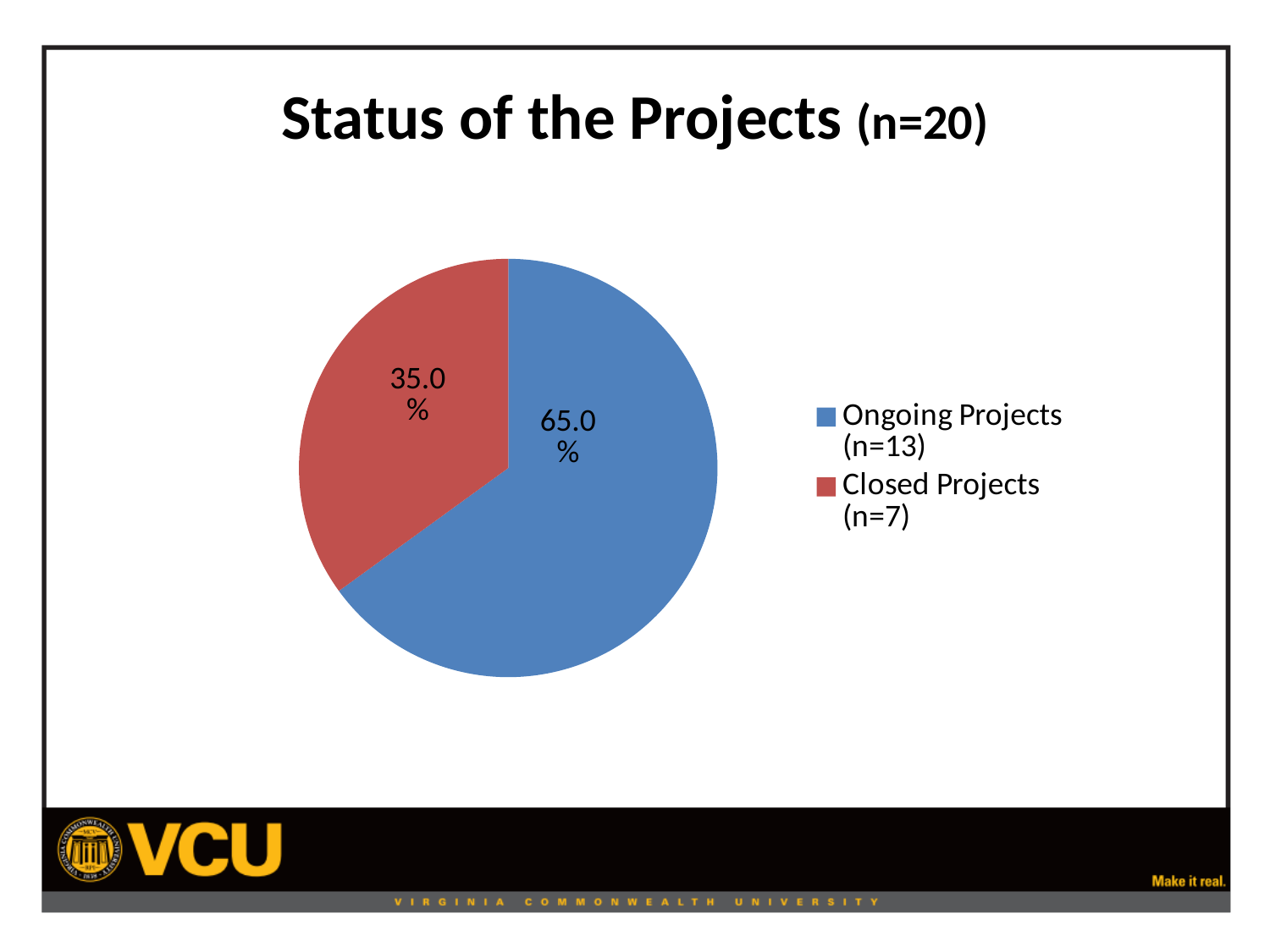
How many projects are ongoing according to the legend? 13 Which slice of the pie is the largest? Ongoing Projects (n=13) What is the title of the chart? Status of the Projects (n=20) Which slice of the pie is the smallest? Closed Projects (n=7) How many entries does the legend list? 2 What colour is the Closed Projects slice? red How many slices does the pie chart have? 2 What is the difference in percentage points between the Ongoing Projects slice and the Closed Projects slice? 30.0% What kind of chart is shown on the slide? pie chart What percentage of the pie is Closed Projects? 35.0% Which is larger, the Ongoing Projects slice or the Closed Projects slice? Ongoing Projects What percentage of the pie is Ongoing Projects? 65.0%